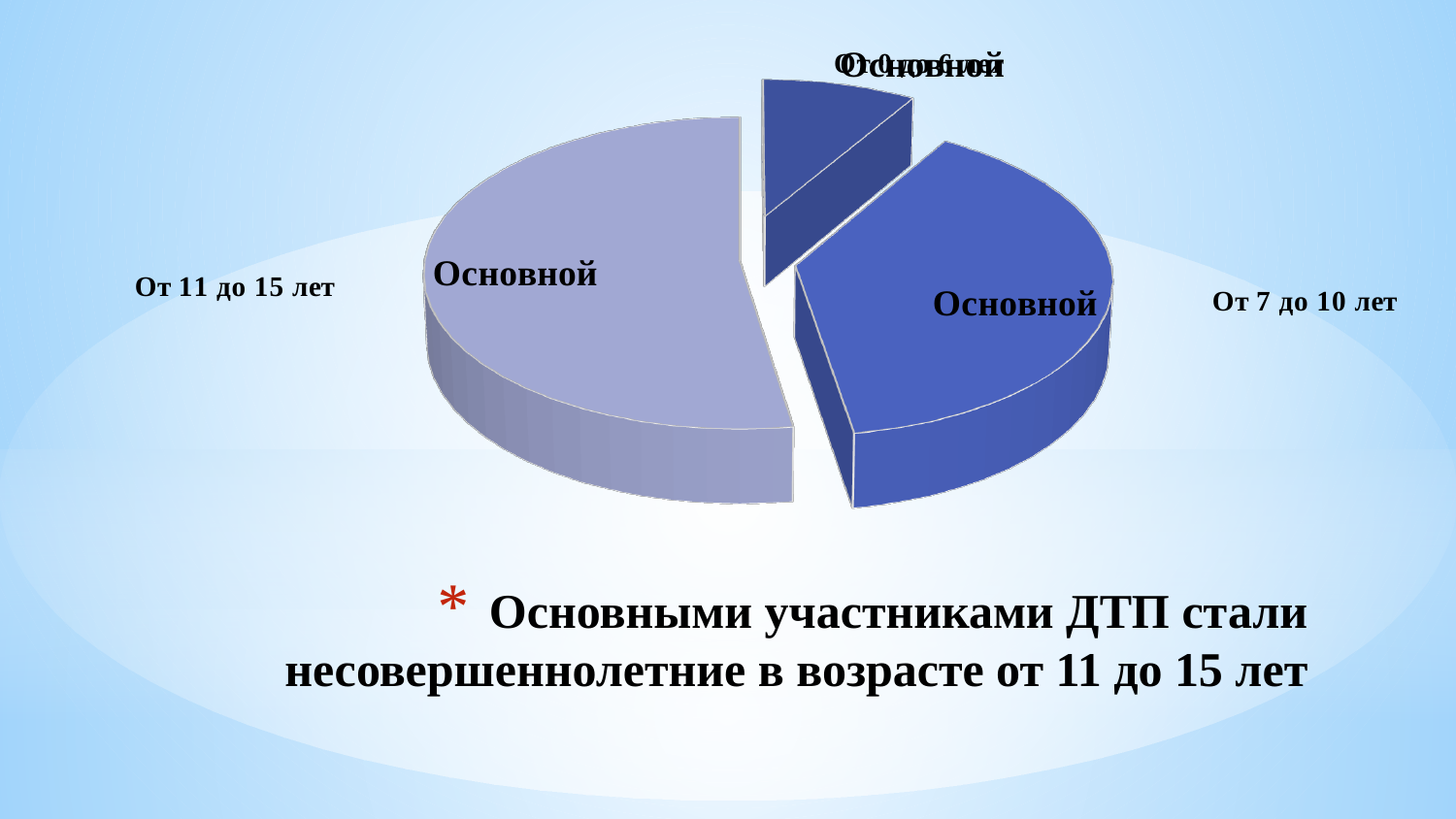
Which slice is larger, "От 11 до 15 лет" or "От 7 до 10 лет"? От 11 до 15 лет Is the pie chart drawn in 3D or flat 2D? 3D What kind of chart is shown on the slide? pie chart What colour is the slice labelled "От 11 до 15 лет"? light purple Which category has the largest slice of the pie chart? От 11 до 15 лет How many slices does the pie chart have? 3 Does the slice for "От 7 до 10 лет" take up more or less than half of the pie? less